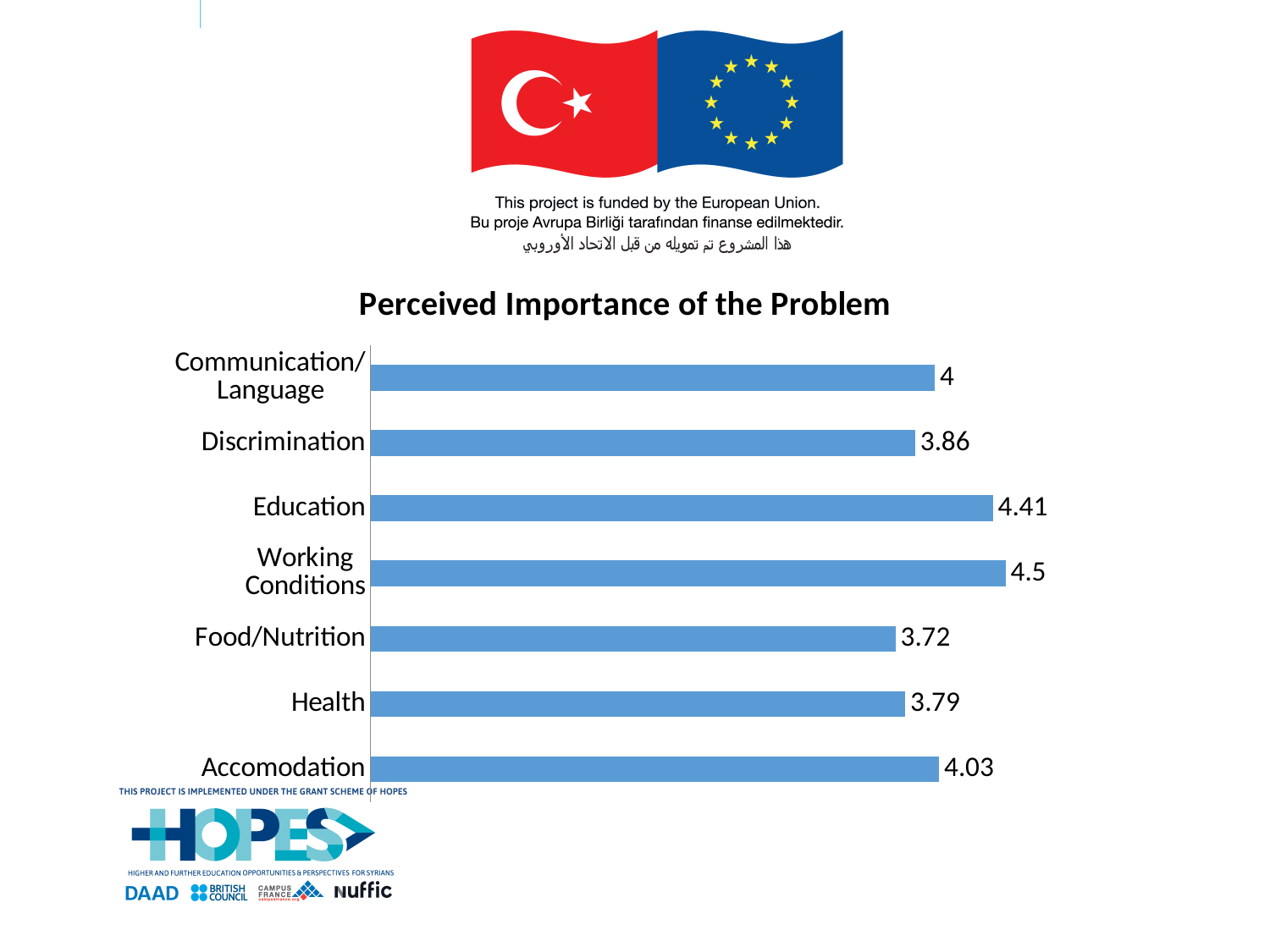
Which has a larger value, Health or Accomodation? Accomodation Which category has the lowest value? Food/Nutrition What kind of chart is shown on the slide? Bar chart What is the value for Education? 4.41 What is the difference between the values for Working Conditions and Food/Nutrition? 0.78 What is the title of the chart? Perceived Importance of the Problem What is the value for Accomodation? 4.03 Which category has the highest value? Working Conditions What is the value for Food/Nutrition? 3.72 What is the value for Communication/Language? 4 How many categories are shown in the chart? 7 What is the difference between the values for Education and Discrimination? 0.55